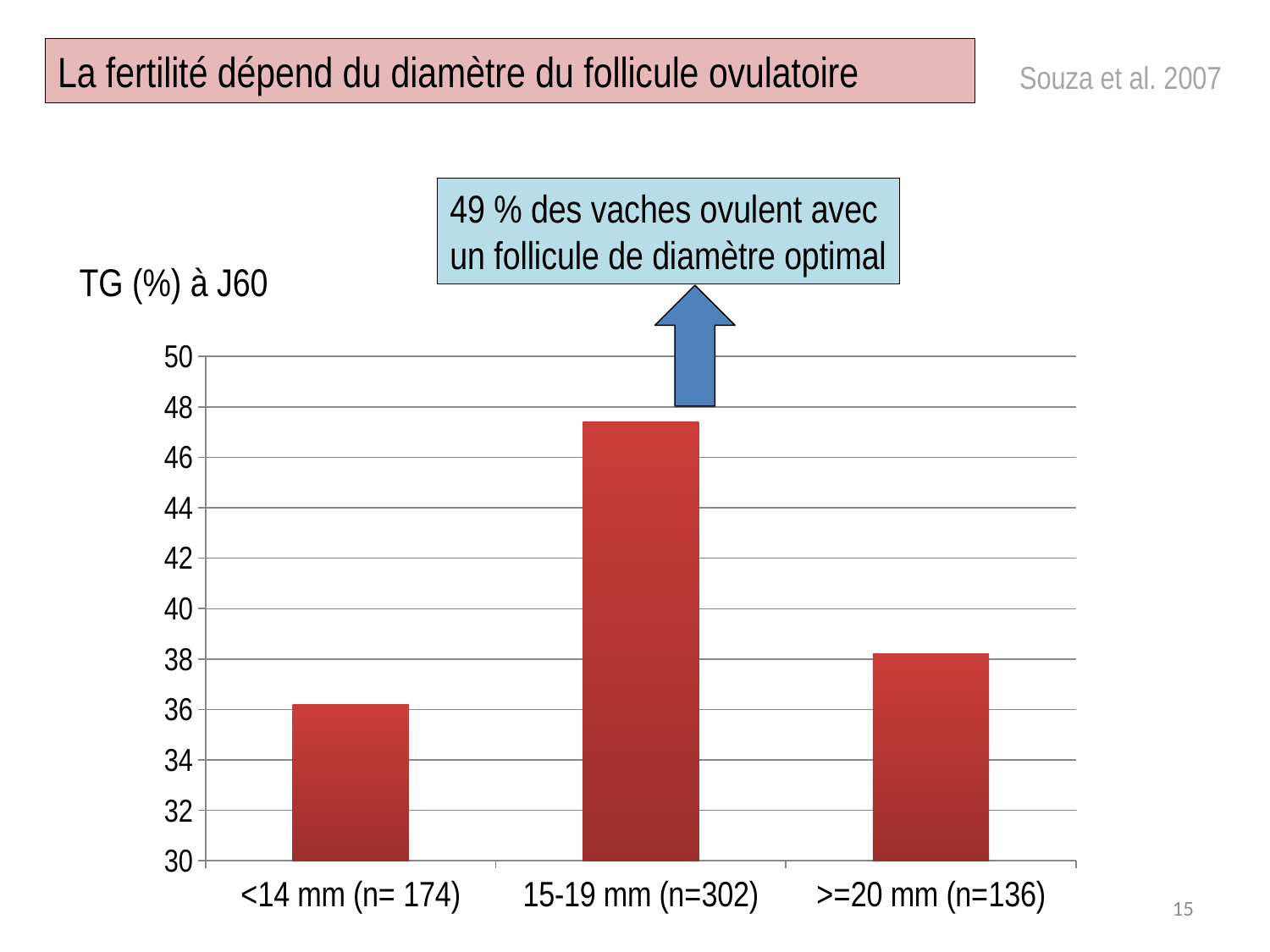
What is the label of the y axis of the chart? TG (%) à J60 Is the value for >=20 mm (n=136) greater or less than 40? less Is the value for <14 mm (n= 174) greater or less than 38? less Which has a higher TG (%) à J60: 15-19 mm (n=302) or >=20 mm (n=136)? 15-19 mm (n=302) Is the value for 15-19 mm (n=302) greater or less than 48? less Which has a higher TG (%) à J60: <14 mm (n= 174) or >=20 mm (n=136)? >=20 mm (n=136) How many categories (follicle diameter groups) are plotted on the chart? 3 Which follicle diameter group has the lowest TG (%) à J60? <14 mm (n= 174) What kind of chart is shown on the slide? bar chart Which follicle diameter group has the highest TG (%) à J60? 15-19 mm (n=302)